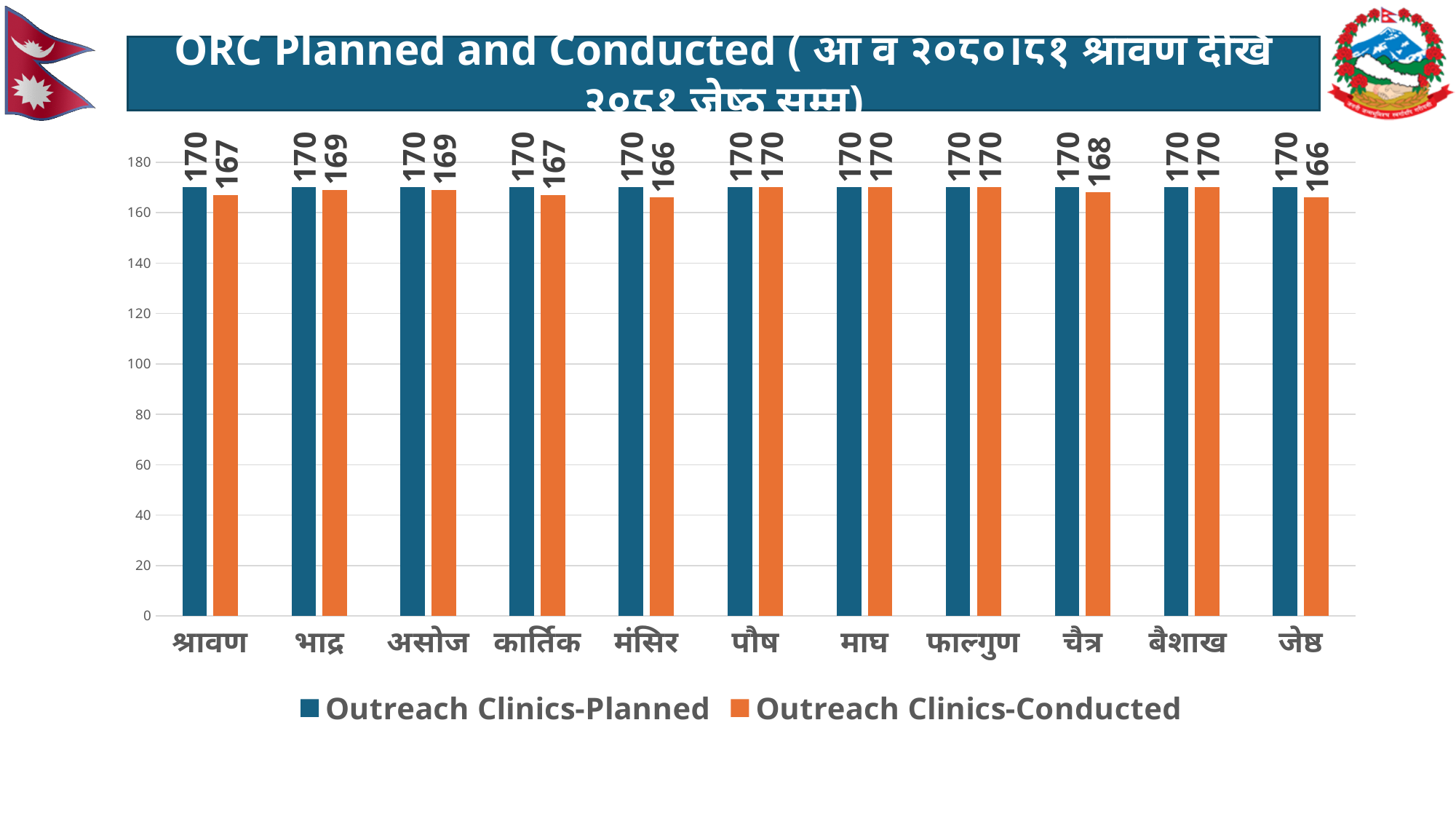
What is the value of Outreach Clinics-Conducted for श्रावण? 167 How many months are shown on the x axis? 11 What is the value of Outreach Clinics-Conducted for चैत्र? 168 What is the difference between Outreach Clinics-Planned and Outreach Clinics-Conducted for मंसिर? 4 What kind of chart is shown on the slide? bar chart How many series does the legend list? 2 Which colour represents Outreach Clinics-Conducted in the legend? orange Which is larger for कार्तिक: Outreach Clinics-Planned or Outreach Clinics-Conducted? Outreach Clinics-Planned What is the value of Outreach Clinics-Conducted for जेष्ठ? 166 Is the value of Outreach Clinics-Conducted for पौष greater or less than 160? greater What is the value of Outreach Clinics-Planned for कार्तिक? 170 What is the difference between Outreach Clinics-Planned and Outreach Clinics-Conducted for भाद्र? 1